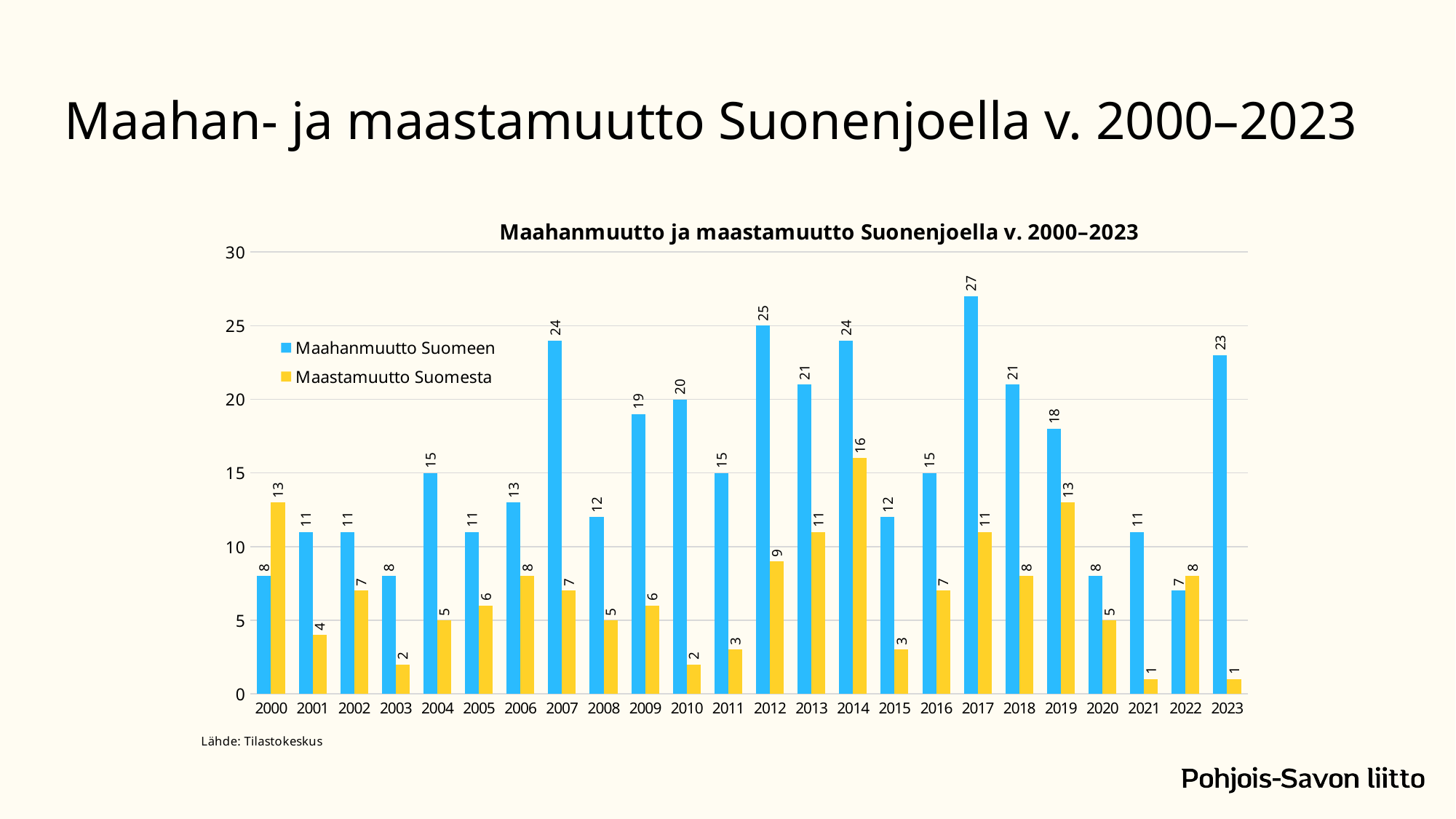
What is the title of the chart? Maahanmuutto ja maastamuutto Suonenjoella v. 2000–2023 Which is larger in 2000, Maahanmuutto Suomeen or Maastamuutto Suomesta? Maastamuutto Suomesta How many series does the legend list? 2 In which year is Maahanmuutto Suomeen lowest? 2022 What is the value of Maahanmuutto Suomeen in 2017? 27 In which year is Maastamuutto Suomesta highest? 2014 What is the value of Maastamuutto Suomesta in 2014? 16 In which year is Maahanmuutto Suomeen highest? 2017 What kind of chart is shown on the slide? Bar chart How many years are shown on the x axis? 24 What is the value of Maahanmuutto Suomeen in 2023? 23 What is the difference between Maahanmuutto Suomeen and Maastamuutto Suomesta in 2023? 22